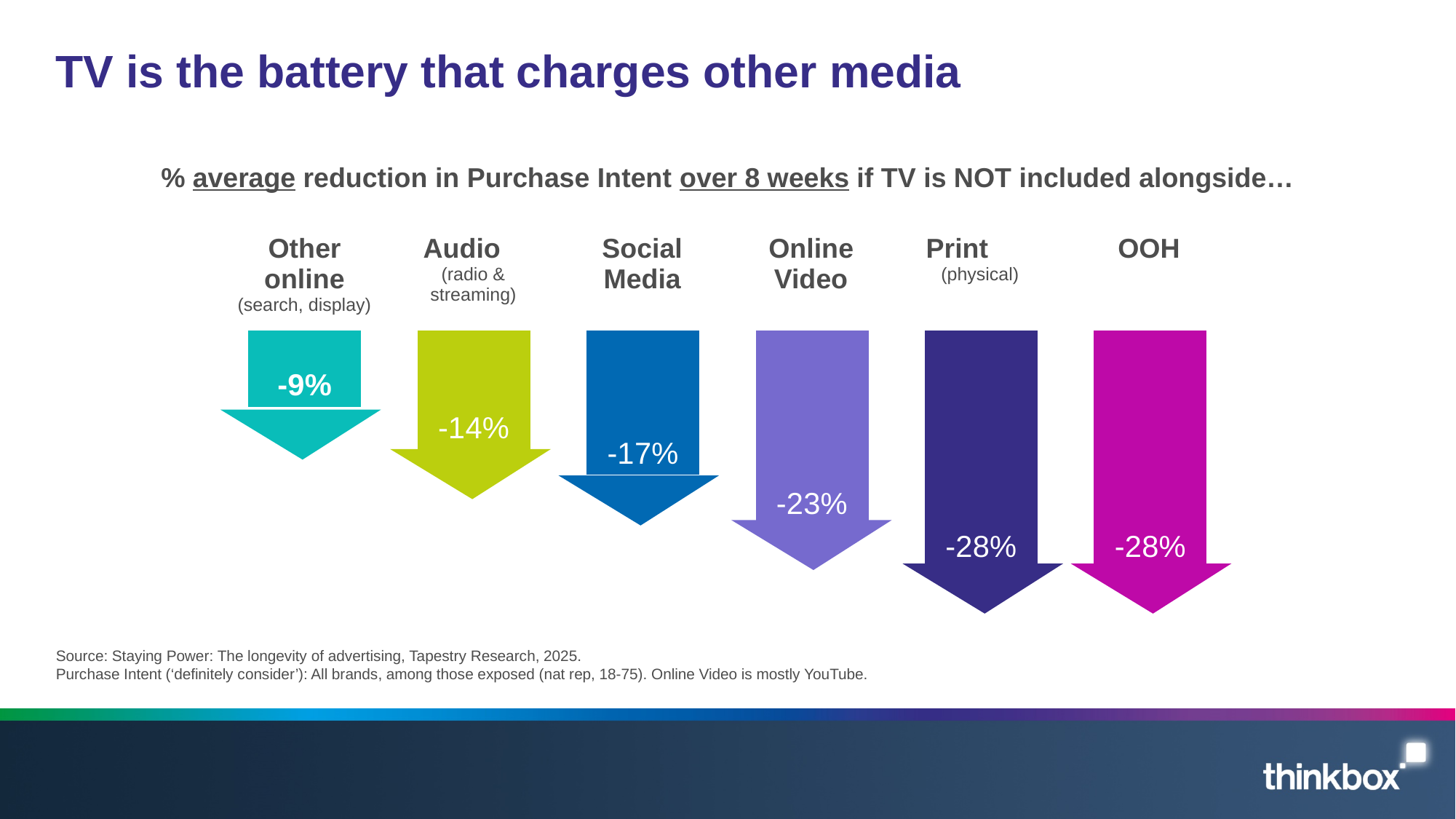
What is the difference between the values for Online Video and Social Media? 6 percentage points What is the value shown for Online Video? -23% Do the reductions get larger or smaller moving from left to right across the chart? Larger What is the title of the slide? TV is the battery that charges other media What is the value shown for Audio (radio & streaming)? -14% Which shows a larger reduction, Social Media or Audio? Social Media Which category shows the smallest reduction in Purchase Intent? Other online (search, display) What is the value shown for Print (physical)? -28% What is the value shown for Social Media? -17% What is the value shown for Other online (search, display)? -9% What is the difference between the values for Audio and Other online? 5 percentage points How many media categories are shown in the chart? 6